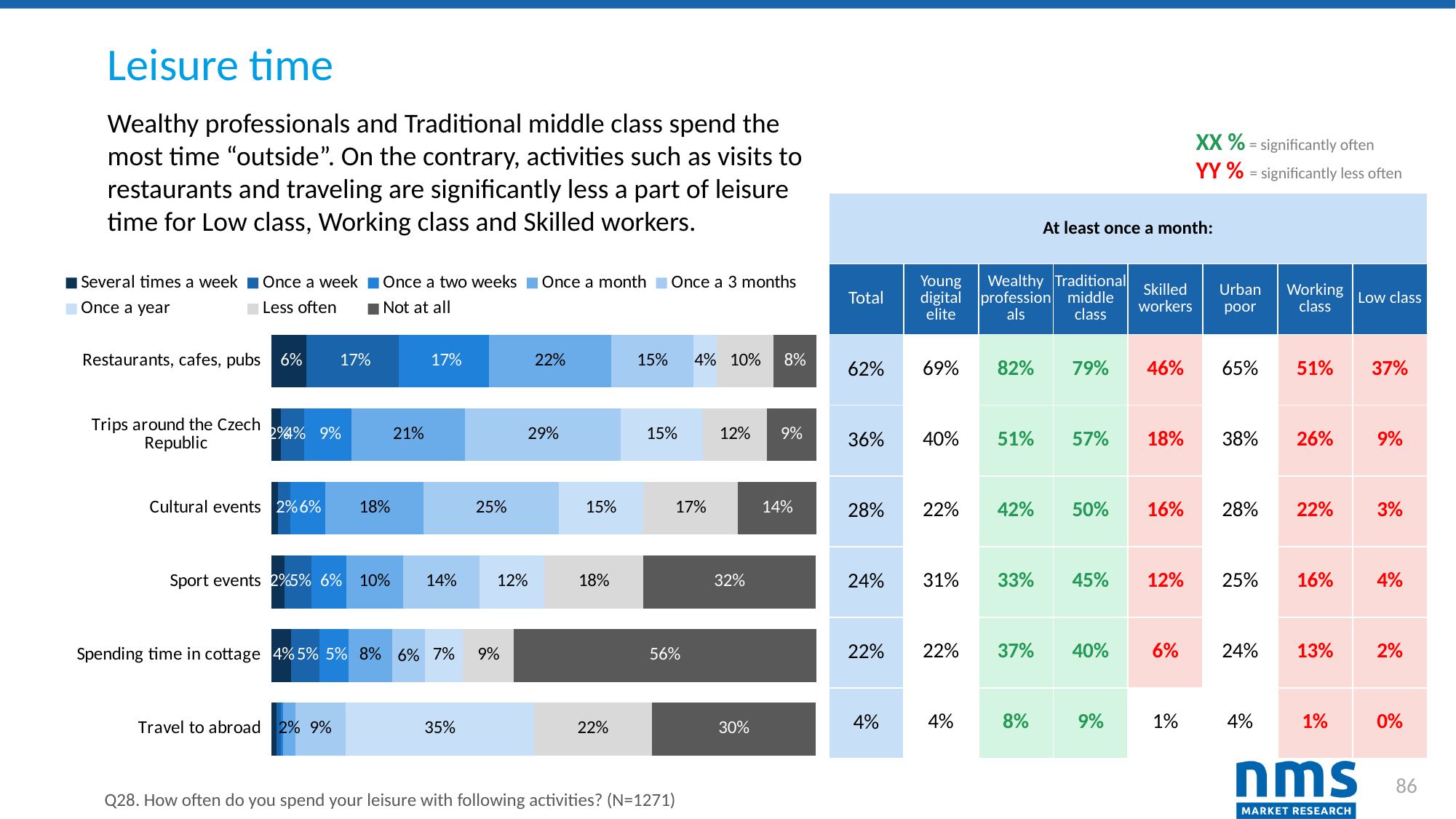
What kind of chart is shown on the slide? Stacked bar chart What is the difference between the 'Not at all' values for Spending time in cottage and Travel to abroad? 26 percentage points What is the 'Not at all' value for Spending time in cottage? 56% What is the 'Once a month' value for Restaurants, cafes, pubs? 22% What is the 'Not at all' value for Sport events? 32% Which legend entry is shown in dark grey? Not at all How many activity categories are plotted in the chart? 6 How many series does the chart legend list? 8 What is the 'Once a 3 months' value for Trips around the Czech Republic? 29% Which activity has the highest 'Not at all' value? Spending time in cottage Which activity has the lowest 'Not at all' value? Restaurants, cafes, pubs Which has a larger 'Not at all' value: Sport events or Cultural events? Sport events